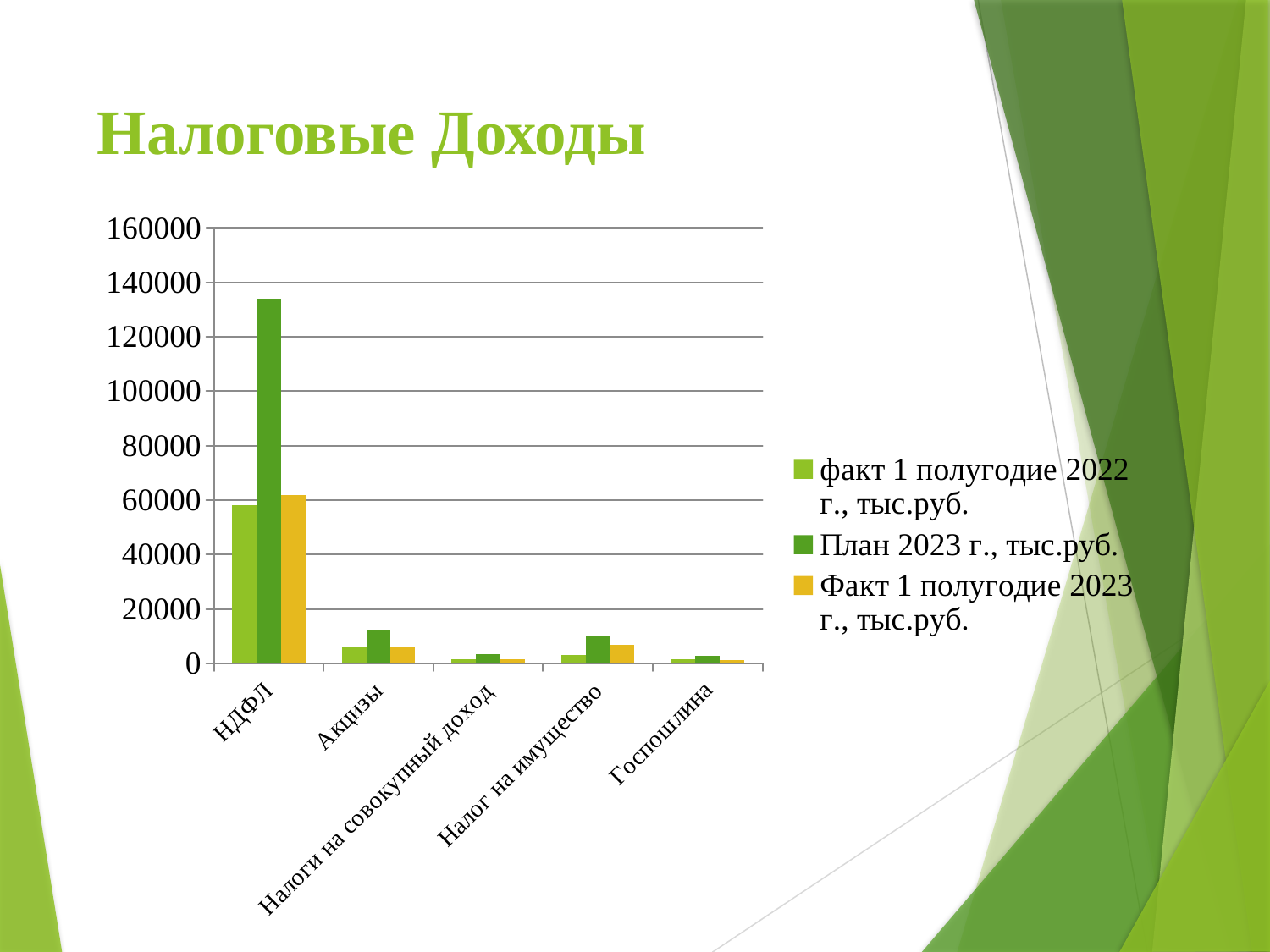
Is the value of 'План 2023 г., тыс.руб.' for НДФЛ greater or less than 120000? greater What is the title of the chart? Налоговые Доходы Is the value of 'Факт 1 полугодие 2023 г., тыс.руб.' for НДФЛ greater or less than 40000? greater For НДФЛ, which is larger: 'План 2023 г., тыс.руб.' or 'факт 1 полугодие 2022 г., тыс.руб.'? План 2023 г., тыс.руб. What kind of chart is shown on the slide? bar chart For Акцизы, which is larger: 'План 2023 г., тыс.руб.' or 'Факт 1 полугодие 2023 г., тыс.руб.'? План 2023 г., тыс.руб. Is the value of 'План 2023 г., тыс.руб.' for Акцизы greater or less than 20000? less How many categories are shown on the x axis of the chart? 5 How many series does the legend list? 3 Which series is shown in yellow in the legend? Факт 1 полугодие 2023 г., тыс.руб. Which category has the highest value for the series 'План 2023 г., тыс.руб.'? НДФЛ